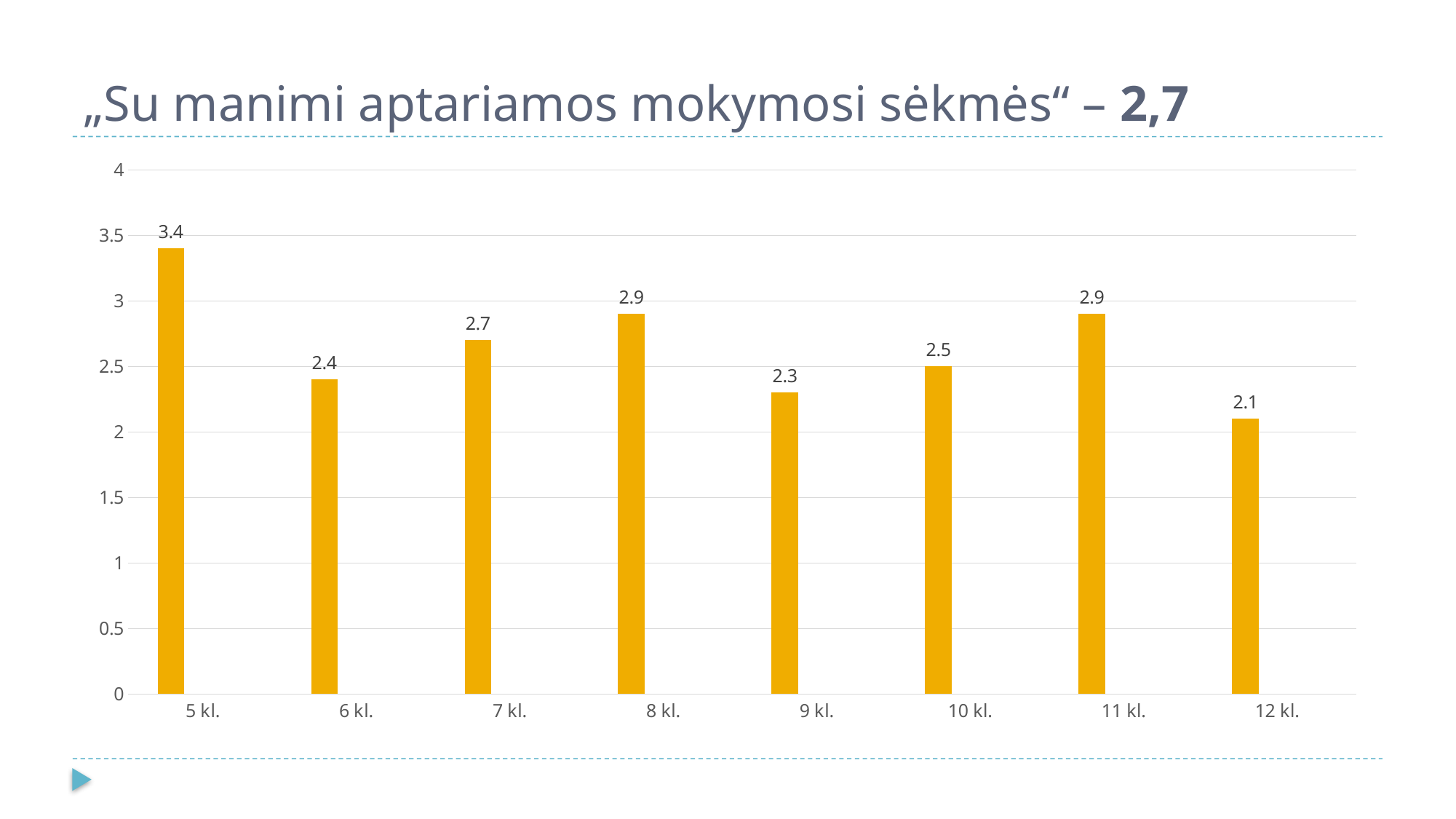
What number is shown in bold at the end of the slide title? 2,7 What is the value for 12 kl.? 2.1 Which class has the lowest value? 12 kl. What is the difference between the values for 7 kl. and 6 kl.? 0.3 Which class has the highest value? 5 kl. Which is larger, the value for 8 kl. or the value for 10 kl.? 8 kl. What kind of chart is shown on the slide? bar chart What is the value for 5 kl.? 3.4 What is the value for 9 kl.? 2.3 How many classes are shown on the x axis? 8 Is the value for 11 kl. greater or less than 2.5? greater What is the difference between the values for 5 kl. and 12 kl.? 1.3